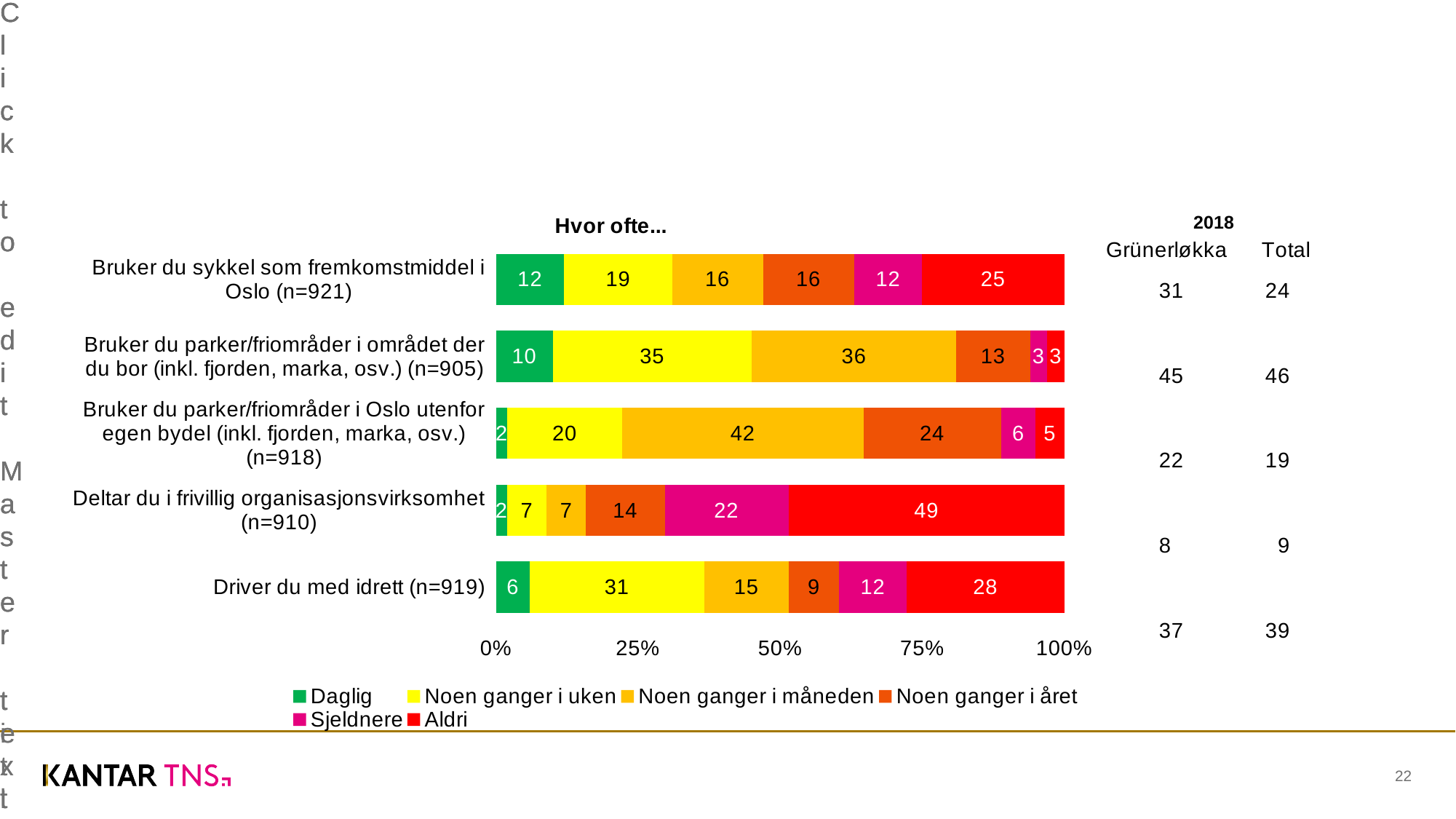
How many categories (bars) are shown in the chart? 5 Which category has the highest value for "Aldri"? Deltar du i frivillig organisasjonsvirksomhet (n=910) Which category has the lowest value for "Aldri"? Bruker du parker/friområder i området der du bor (inkl. fjorden, marka, osv.) (n=905) What is the value for "Aldri" in the "Deltar du i frivillig organisasjonsvirksomhet (n=910)" bar? 49 What is the value for "Noen ganger i måneden" in the "Bruker du parker/friområder i Oslo utenfor egen bydel (inkl. fjorden, marka, osv.) (n=918)" bar? 42 What kind of chart is shown on the slide? Stacked bar chart What is the title of the chart? Hvor ofte... What is the value for "Daglig" in the "Bruker du sykkel som fremkomstmiddel i Oslo (n=921)" bar? 12 Which is larger: the "Noen ganger i uken" value for "Bruker du parker/friområder i området der du bor (n=905)" or for "Driver du med idrett (n=919)"? Bruker du parker/friområder i området der du bor (n=905) What is the value for "Noen ganger i uken" in the "Driver du med idrett (n=919)" bar? 31 What is the difference between the "Aldri" values for "Driver du med idrett (n=919)" and "Bruker du sykkel som fremkomstmiddel i Oslo (n=921)"? 3 How many series does the legend list? 6